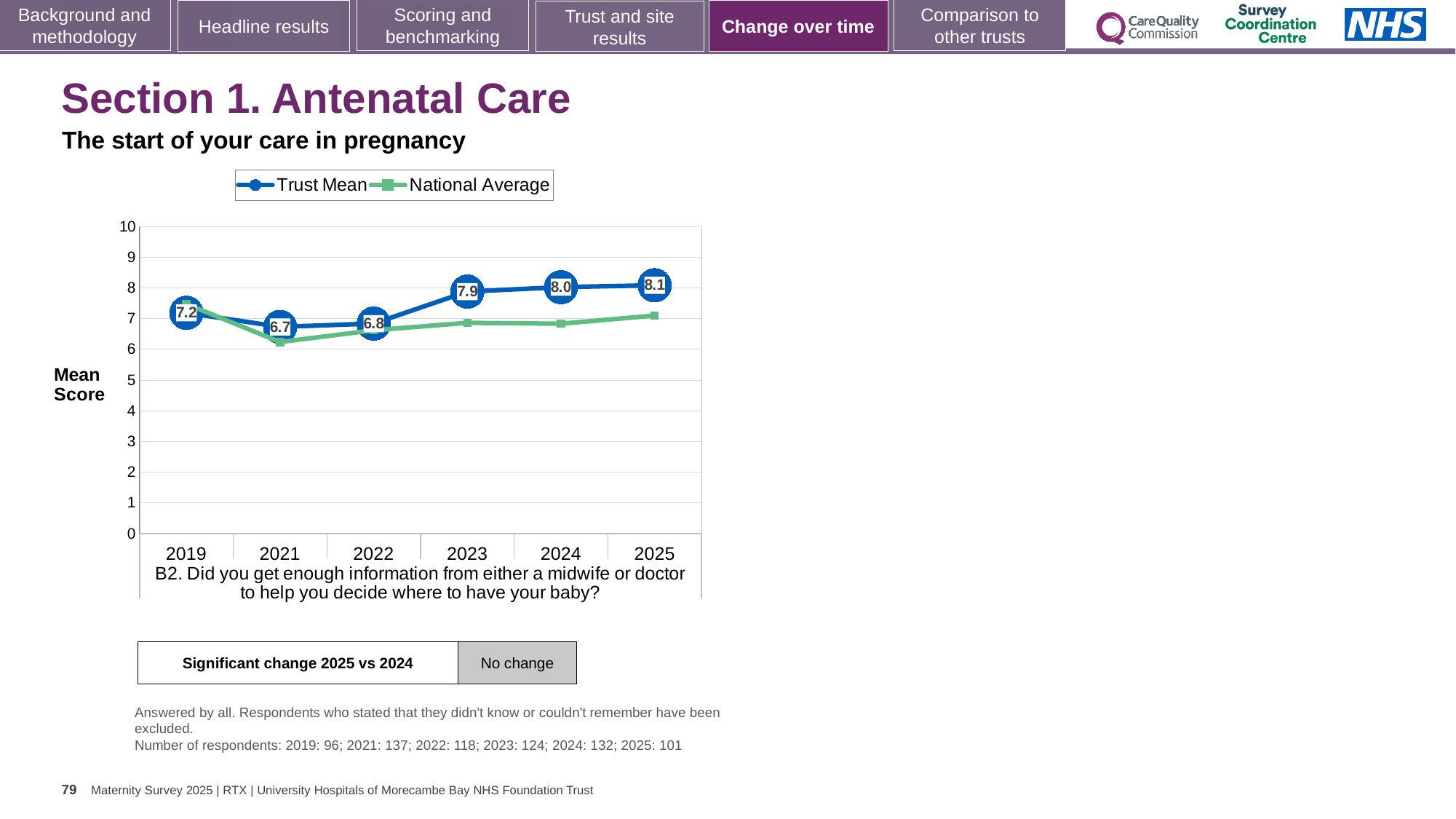
In which year is the Trust Mean lowest? 2021 What kind of chart is shown on the slide? line chart Does the Trust Mean rise or fall from 2022 to 2025? rise In which year is the Trust Mean highest? 2025 What is the difference between the Trust Mean in 2025 and in 2021? 1.4 How many series does the legend list? 2 What is the Trust Mean value for 2025? 8.1 What is the Trust Mean value for 2019? 7.2 What is the Trust Mean value for 2021? 6.7 Which is larger, the Trust Mean in 2023 or in 2022? 2023 Is the National Average value for 2021 greater or less than 7? less How many years are shown on the x axis? 6